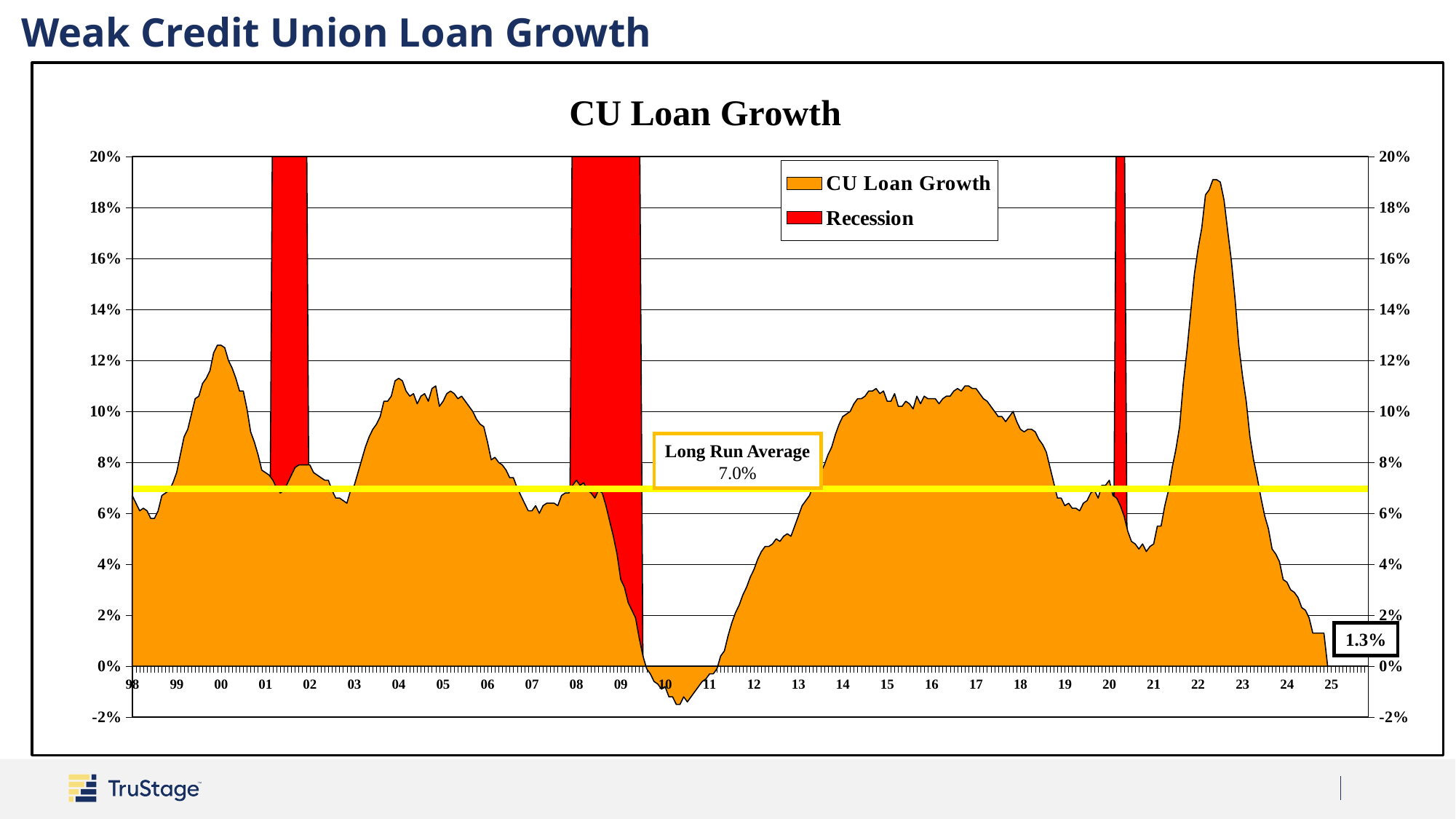
How many recession periods are shaded on the chart? 3 What is the Long Run Average value shown on the chart? 7.0% How many entries does the chart legend list? 2 Does CU Loan Growth rise or fall from 2022 to 2025? fall Is the CU Loan Growth value around 2010 greater or less than 0%? less Is the peak CU Loan Growth value around 2022 greater or less than 18%? greater In which year does CU Loan Growth reach its highest peak on the chart? 2022 What is the most recent CU Loan Growth value labeled on the chart? 1.3% What kind of chart is shown on the slide? area chart Is the CU Loan Growth value around 2000 greater or less than 10%? greater What is the title of the chart? CU Loan Growth Around which year does CU Loan Growth reach its lowest point on the chart? 2010